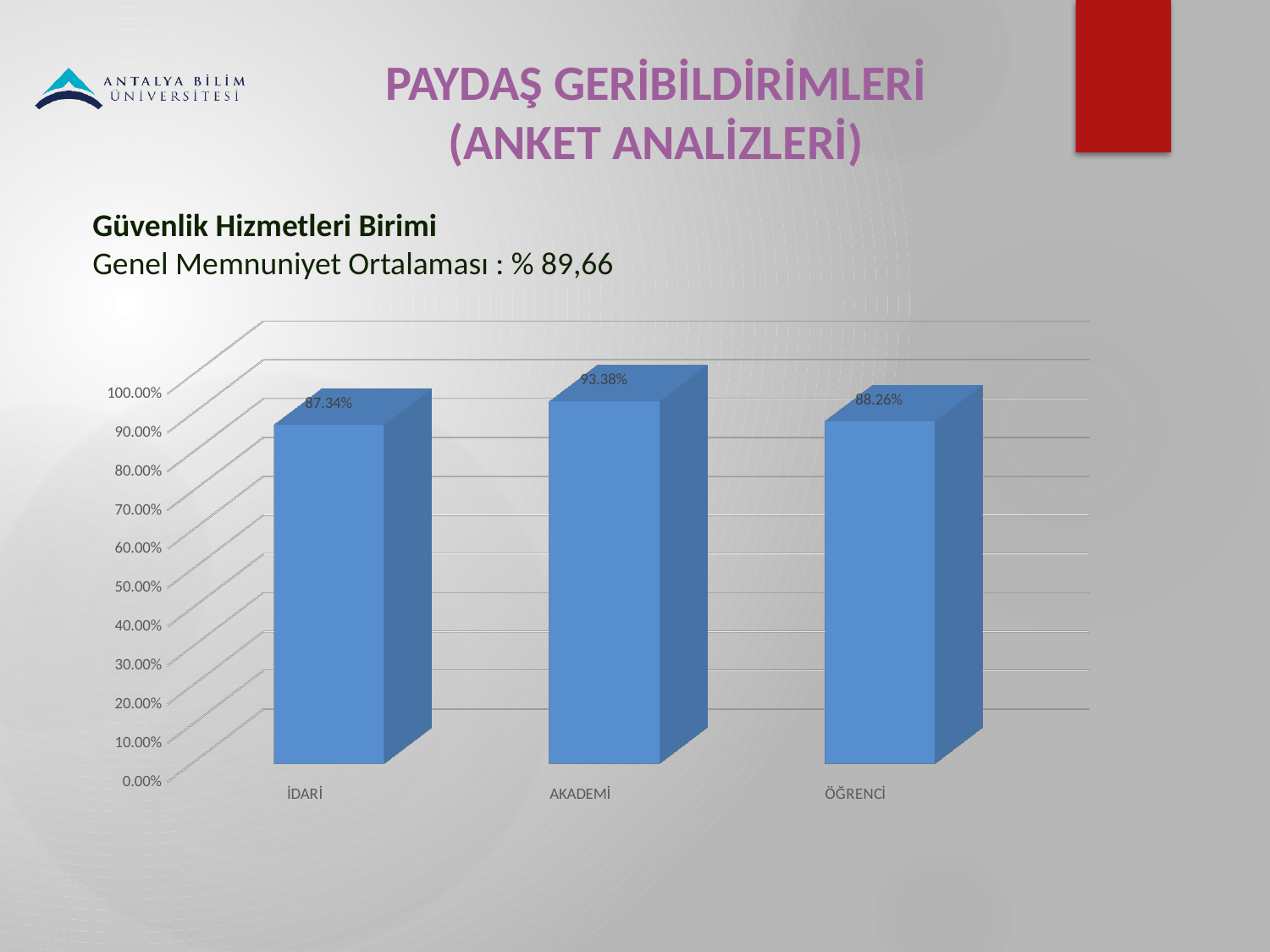
Is the value for İDARİ greater or less than 80.00%? greater What is the value for AKADEMİ? 93.38% Which is larger, the value for AKADEMİ or the value for ÖĞRENCİ? AKADEMİ What is the value for ÖĞRENCİ? 88.26% What is the value for İDARİ? 87.34% How many categories are shown on the x axis? 3 What kind of chart is shown on the slide? bar chart What is the difference between the values for AKADEMİ and İDARİ? 6.04% What is the Genel Memnuniyet Ortalaması stated above the chart? % 89,66 What is the difference between the values for ÖĞRENCİ and İDARİ? 0.92% Which category has the highest value? AKADEMİ Which category has the lowest value? İDARİ